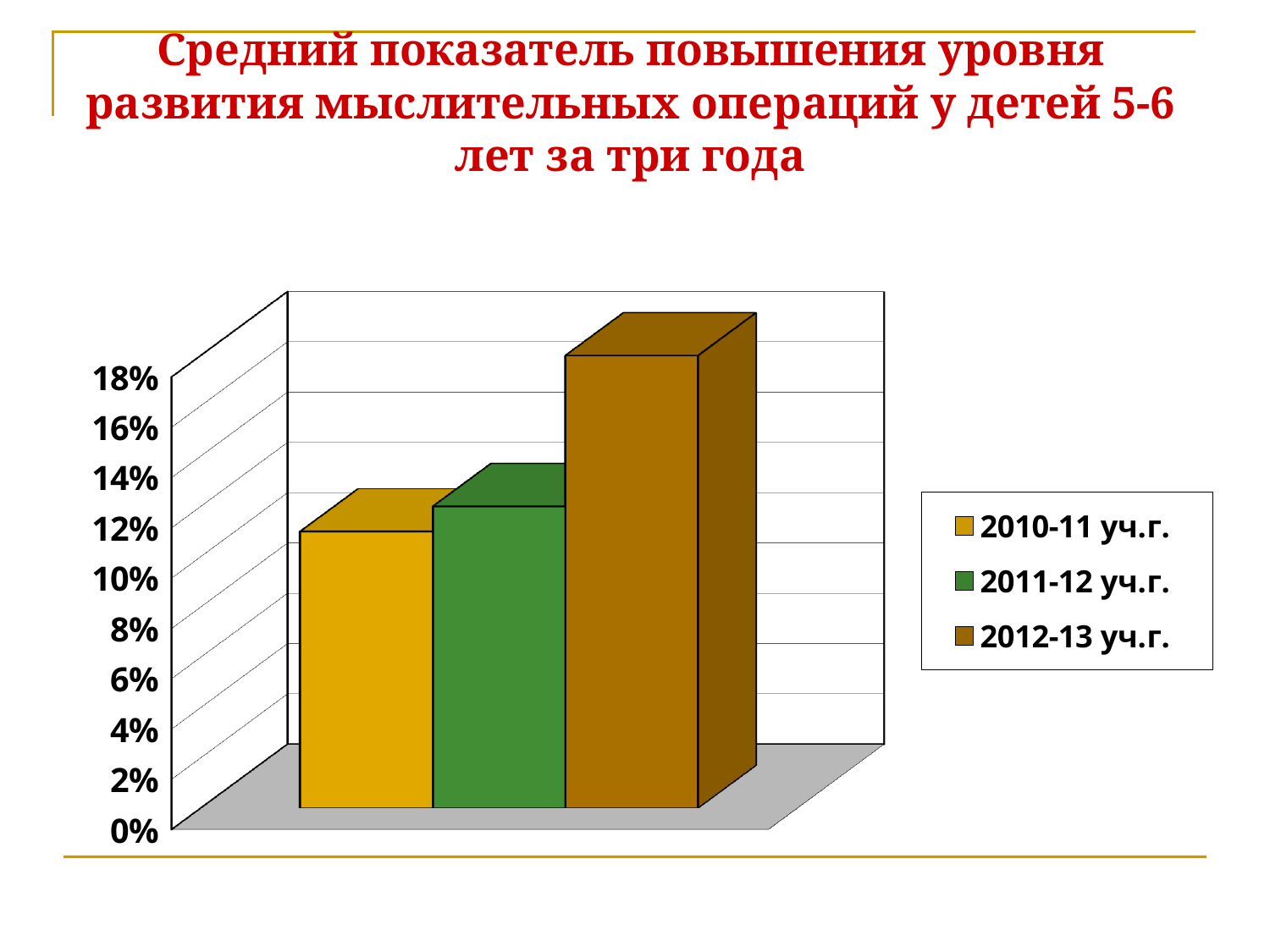
What kind of chart is shown on the slide? bar chart Which series has the highest value? 2012-13 уч.г. What is the highest value shown on the vertical axis? 18% Is the value for 2010-11 уч.г. greater or less than 10%? greater What colour is the bar for 2011-12 уч.г.? green How many bars are plotted in the chart? 3 Do the values rise or fall from 2010-11 уч.г. to 2012-13 уч.г.? rise Which is larger, the value for 2012-13 уч.г. or the value for 2010-11 уч.г.? 2012-13 уч.г. Is the value for 2012-13 уч.г. greater or less than 14%? greater Is the value for 2011-12 уч.г. greater or less than 16%? less Which series has the lowest value? 2010-11 уч.г. How many series does the legend list? 3